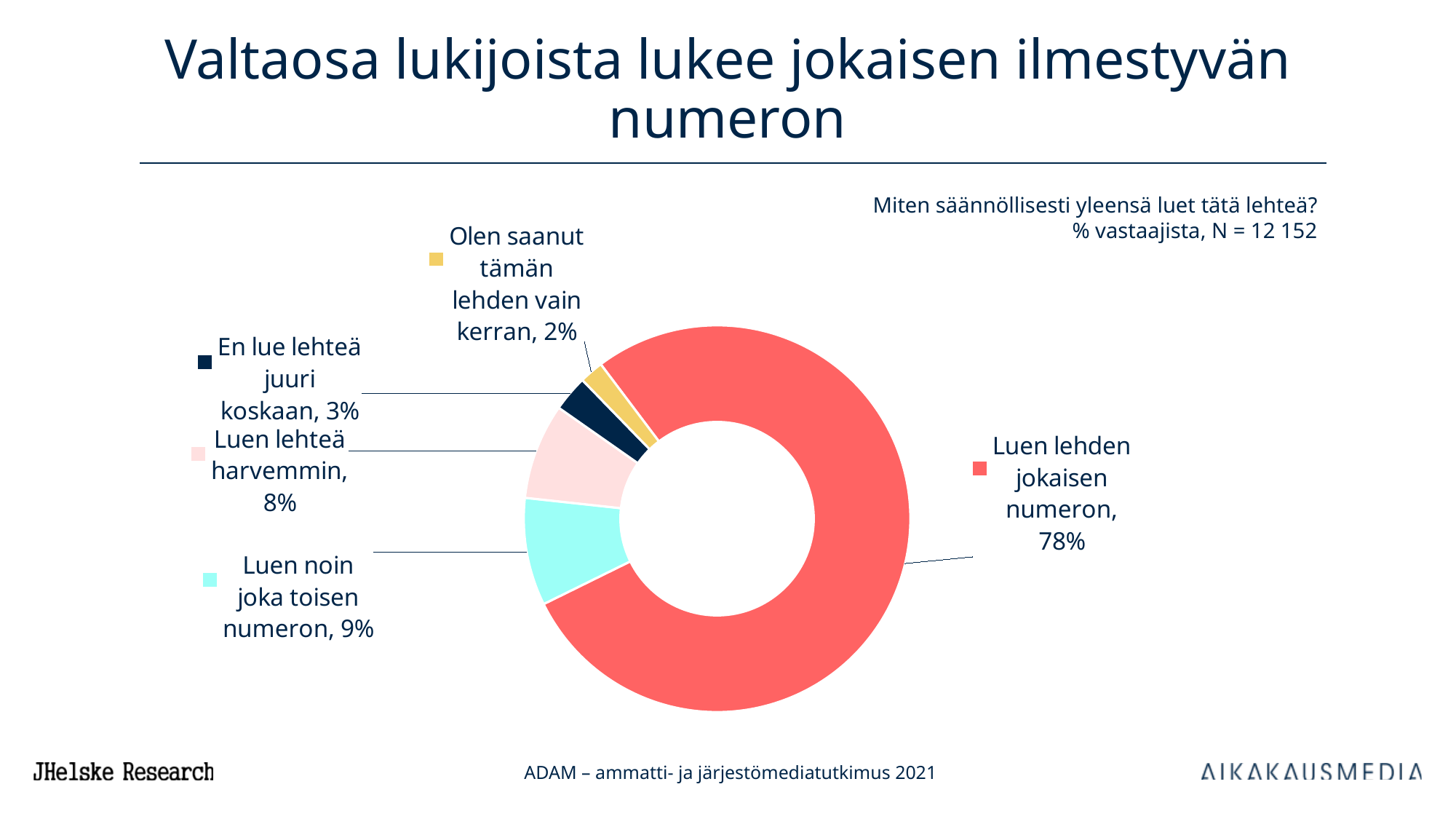
What share of respondents answered "Olen saanut tämän lehden vain kerran"? 2% What is the number of respondents (N) stated on the slide? 12 152 What is the difference in percentage points between "Luen lehden jokaisen numeron" and "Luen noin joka toisen numeron"? 69 Which category has the largest share of the chart? Luen lehden jokaisen numeron What share of respondents answered "Luen noin joka toisen numeron"? 9% What share of respondents answered "Luen lehden jokaisen numeron"? 78% How many categories are shown in the chart? 5 Which category has the smallest share of the chart? Olen saanut tämän lehden vain kerran What share of respondents answered "Luen lehteä harvemmin"? 8% Which is larger: the share for "Luen lehteä harvemmin" or for "En lue lehteä juuri koskaan"? Luen lehteä harvemmin What share of respondents answered "En lue lehteä juuri koskaan"? 3% What kind of chart is shown on the slide? Pie chart (doughnut)